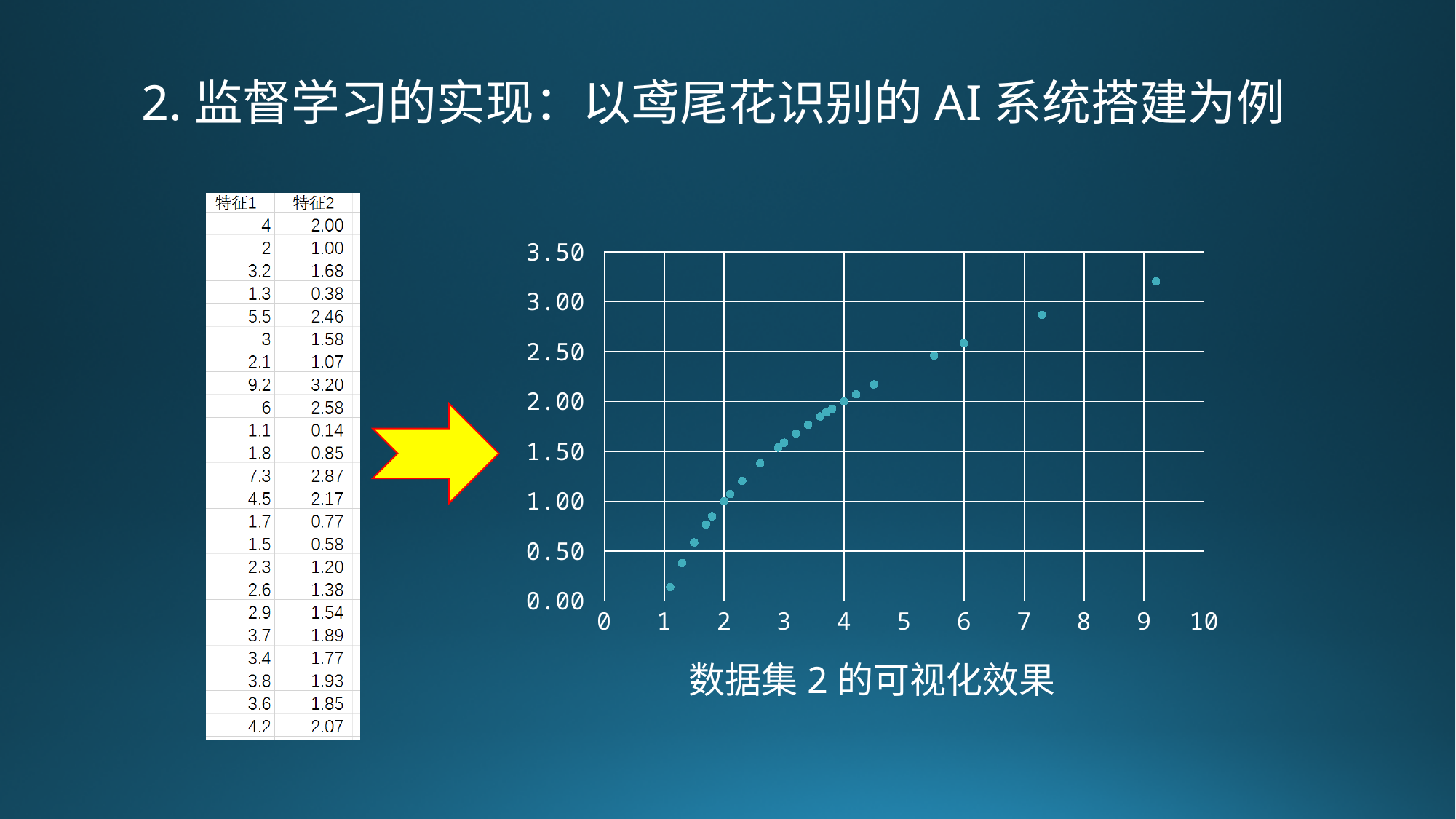
What is the 特征2 value for the point where 特征1 is 1.1? 0.14 Do the plotted values rise or fall as 特征1 increases along the x axis? rise How many data points are plotted in the scatter chart (as listed in the table)? 23 What is the 特征2 value for the point where 特征1 is 7.3? 2.87 Is the 特征2 value for the point at 特征1 = 1.3 greater or less than 0.50? less Which 特征1 value corresponds to the lowest point on the chart? 1.1 What is the caption/title under the chart? 数据集 2 的可视化效果 What kind of chart is shown on the slide? scatter chart What is the 特征2 value for the point where 特征1 is 9.2? 3.20 What is the difference between the highest and lowest 特征2 values plotted? 3.06 Which 特征1 value corresponds to the highest point on the chart? 9.2 Is the 特征2 value for the point at 特征1 = 7.3 greater or less than 2.50? greater